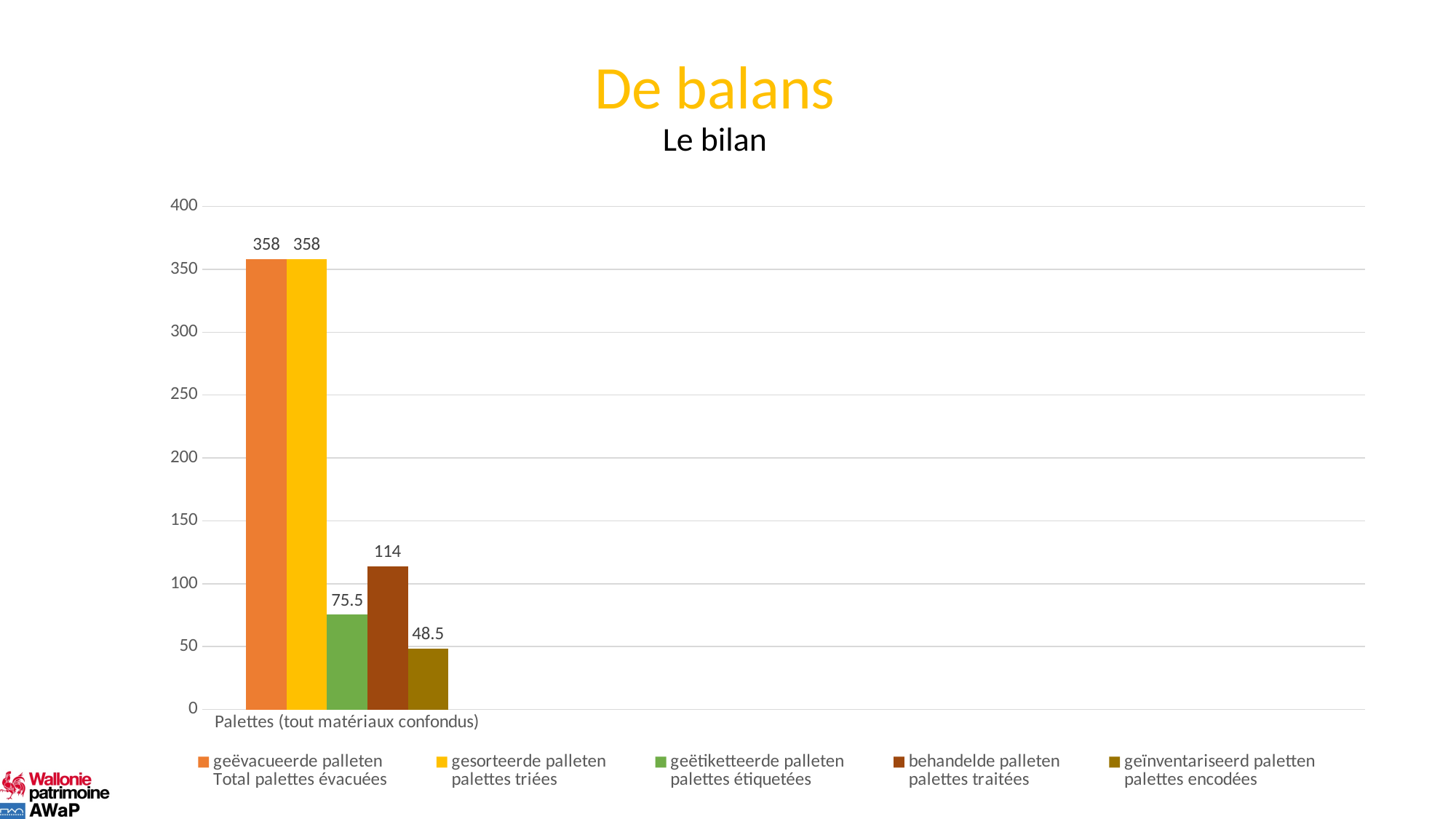
What is the value for 'behandelde palleten / palettes traitées'? 114 What is the value for 'geïnventariseerd palleten / palettes encodées'? 48.5 What is the value for 'geëtiketteerde palleten / palettes étiquetées'? 75.5 How many series does the legend list? 5 What is the label of the category on the x axis? Palettes (tout matériaux confondus) Which is larger: the value for 'behandelde palleten' or the value for 'geëtiketteerde palleten'? behandelde palleten What is the value for 'gesorteerde palleten / palettes triées'? 358 What kind of chart is shown on the slide? bar chart What is the difference between the value for 'behandelde palleten' and the value for 'geëtiketteerde palleten'? 38.5 Which series has the lowest value? geïnventariseerd palleten / palettes encodées What is the value for 'geëvacueerde palleten / Total palettes évacuées'? 358 What is the difference between the value for 'gesorteerde palleten' and the value for 'behandelde palleten'? 244